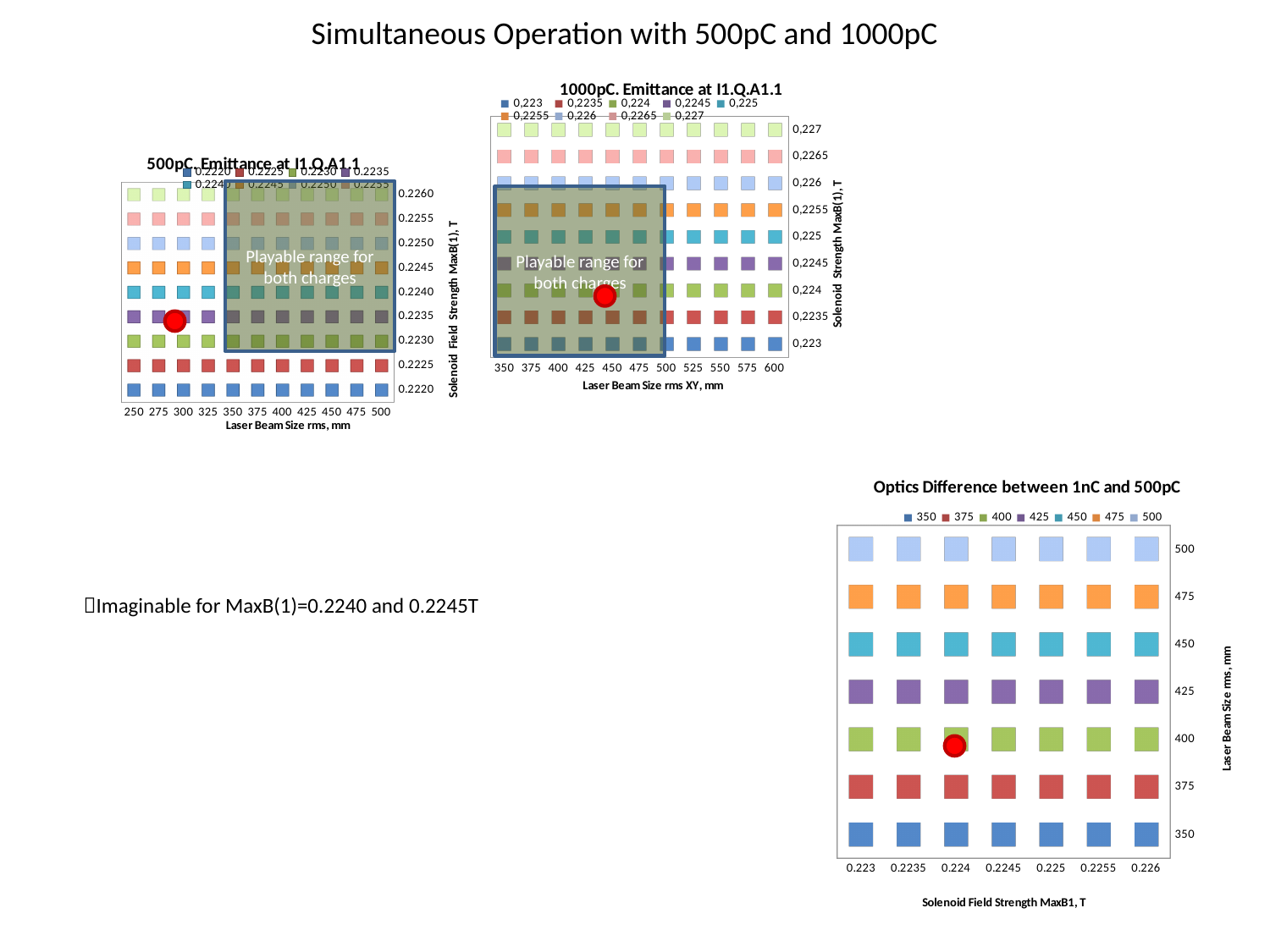
In the "Optics Difference between 1nC and 500pC" chart, at which x-axis value is the red dot placed? 0.224 In the "1000pC. Emittance at I1.Q.A1.1" chart, how many values are shown on the x axis? 11 What kind of chart is the "Optics Difference between 1nC and 500pC" chart? scatter chart In the "1000pC. Emittance at I1.Q.A1.1" chart, at which x-axis value is the red dot placed? 450 What is the x-axis title of the "Optics Difference between 1nC and 500pC" chart? Solenoid Field Strength MaxB1, T How many series does the legend of the "1000pC. Emittance at I1.Q.A1.1" chart list? 9 In the "500pC. Emittance at I1.Q.A1.1" chart, how many values are shown on the x axis? 11 What is the x-axis title of the "1000pC. Emittance at I1.Q.A1.1" chart? Laser Beam Size rms XY, mm In the "Optics Difference between 1nC and 500pC" chart, how many values are shown on the x axis? 7 In the "Optics Difference between 1nC and 500pC" chart, at which y-axis value is the red dot placed? 400 How many series does the legend of the "Optics Difference between 1nC and 500pC" chart list? 7 In the "500pC. Emittance at I1.Q.A1.1" chart, at which y-axis value is the red dot placed? 0.2235